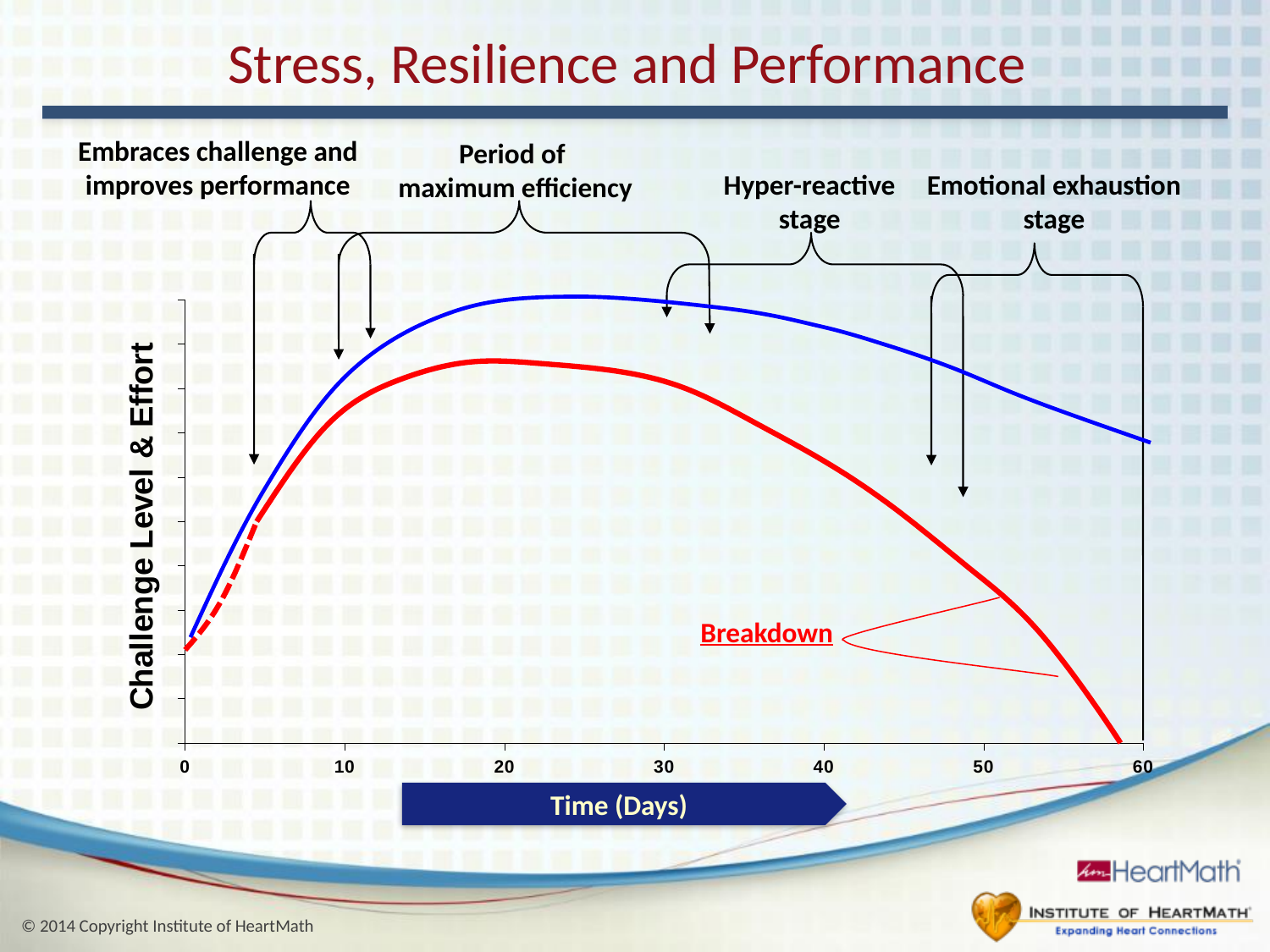
What word is written in red next to the steep drop of the red curve? Breakdown What is the highest value shown on the x axis? 60 How many curves are plotted on the chart? 2 Do the curves rise or fall between day 0 and day 20? rise Do the curves rise or fall between day 40 and day 60? fall Which curve reaches the higher peak, the blue one or the red one? blue What kind of chart is shown on the slide? line chart How many labeled tick values are there on the x axis? 7 What is the label on the x axis of the chart? Time (Days) Which stage is labeled at the far right of the chart, above the end of the curves? Emotional exhaustion stage At day 60, which curve is higher, the blue one or the red one? blue What is the title of the slide's chart? Stress, Resilience and Performance